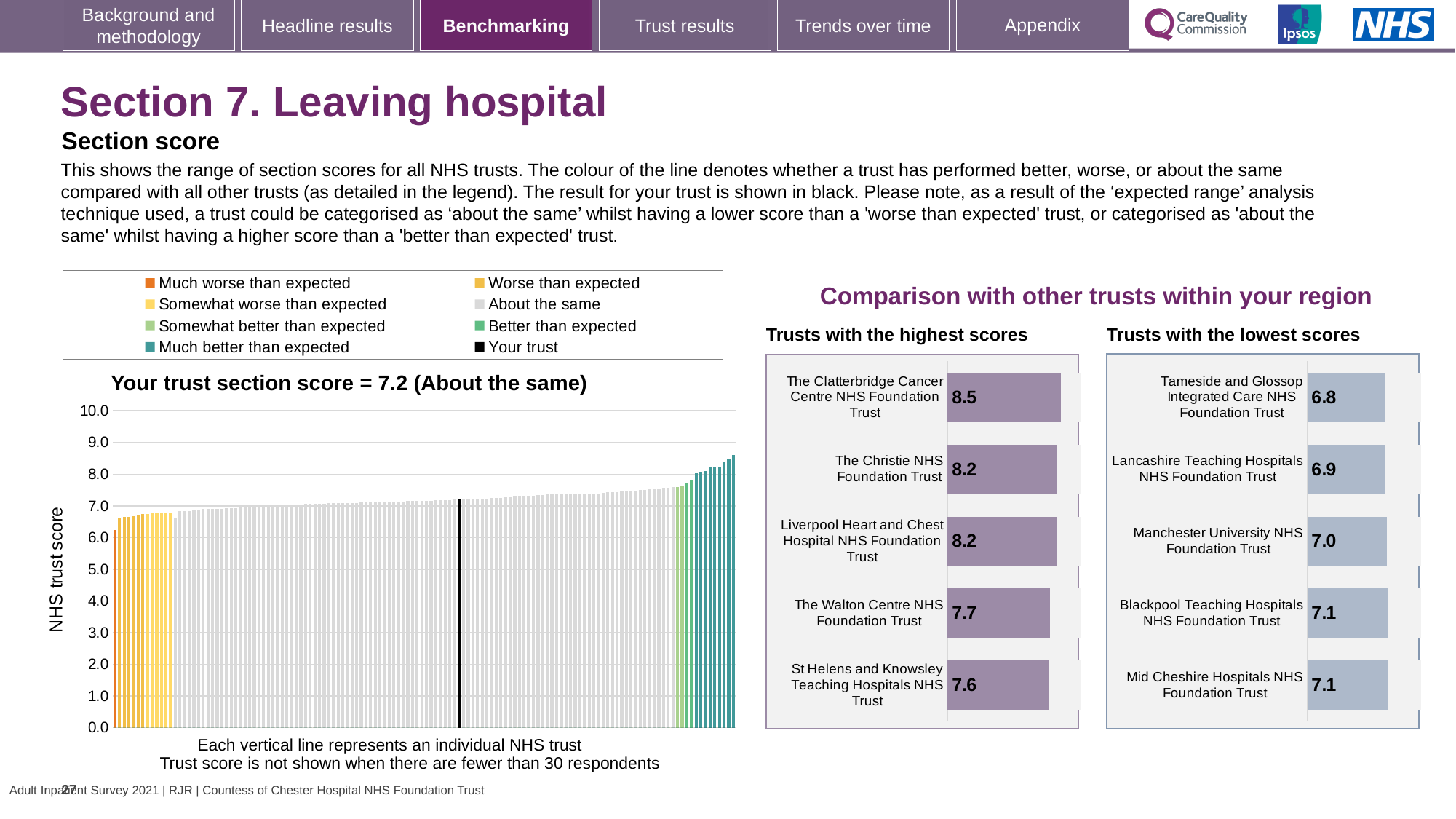
In the main chart 'Your trust section score', is the value of the tallest bar greater or less than 8.0? greater In the 'Trusts with the highest scores' chart, what is the score for The Clatterbridge Cancer Centre NHS Foundation Trust? 8.5 What kind of chart is the main 'Your trust section score' chart? Bar chart In the main chart 'Your trust section score', what is the section score for your trust? 7.2 How many trusts are shown in the 'Trusts with the lowest scores' chart? 5 In the 'Trusts with the highest scores' chart, what is the difference between the scores of The Clatterbridge Cancer Centre NHS Foundation Trust and St Helens and Knowsley Teaching Hospitals NHS Trust? 0.9 In the main chart 'Your trust section score', how is your trust's score categorised? About the same In the 'Trusts with the lowest scores' chart, what is the score for Manchester University NHS Foundation Trust? 7.0 How many entries does the legend above the main chart list? 8 In the 'Trusts with the highest scores' chart, which trust has the lowest score? St Helens and Knowsley Teaching Hospitals NHS Trust In the main chart 'Your trust section score', do the trust scores rise or fall from left to right along the x axis? Rise In the 'Trusts with the lowest scores' chart, which trust has the lowest score? Tameside and Glossop Integrated Care NHS Foundation Trust